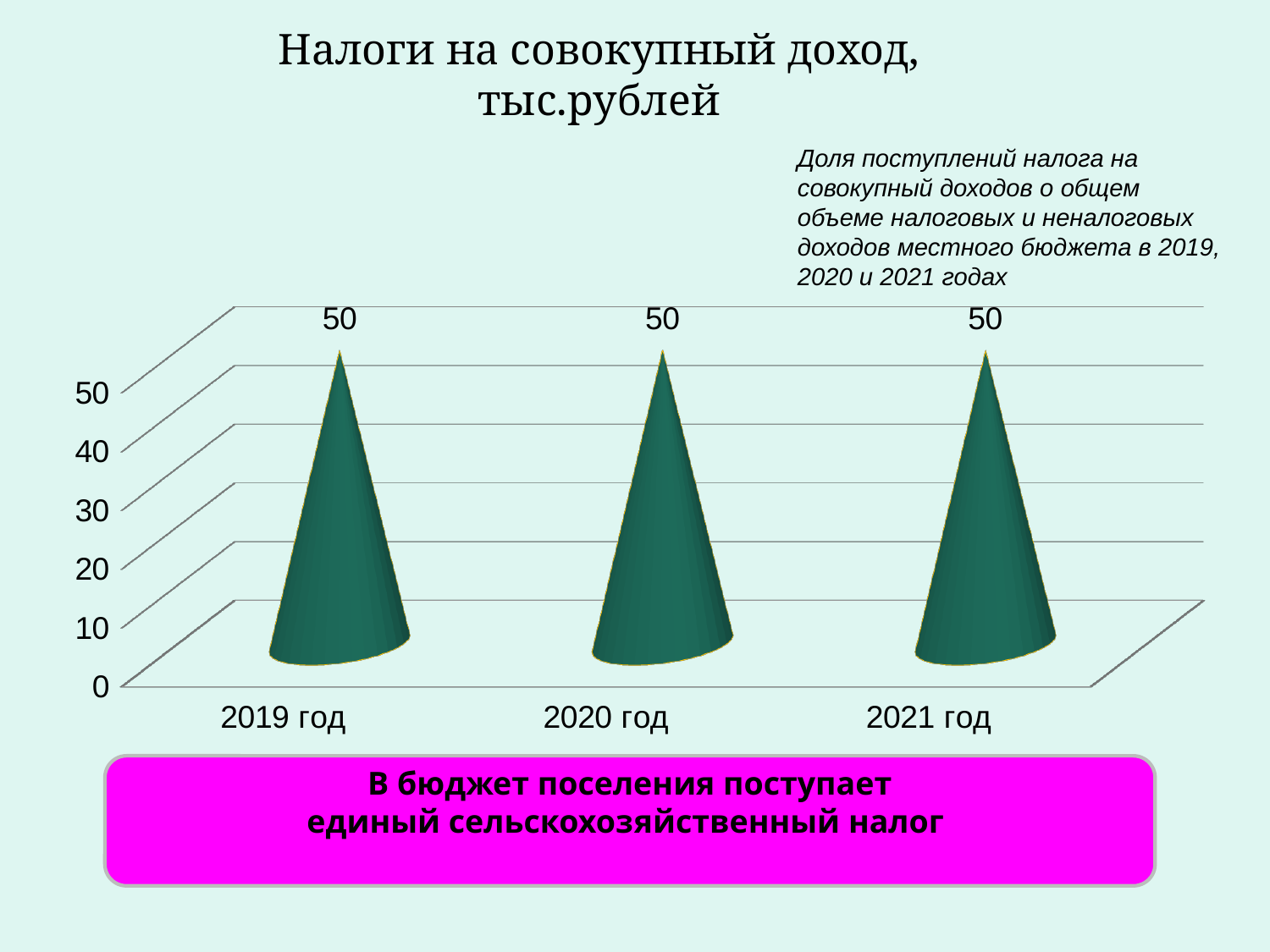
What is the difference between the values for 2021 год and 2019 год? 0 Is the value for 2020 год greater or less than 40? greater What is the value for 2020 год? 50 What is the title of the chart? Налоги на совокупный доход, тыс.рублей Do the values rise, fall, or stay the same from 2019 год to 2021 год? stay the same What is the value for 2019 год? 50 Is the value for 2019 год greater or less than 30? greater What kind of chart is shown on the slide? bar chart How many categories (years) are shown on the chart? 3 What is the highest value shown on the vertical axis? 50 What is the value for 2021 год? 50